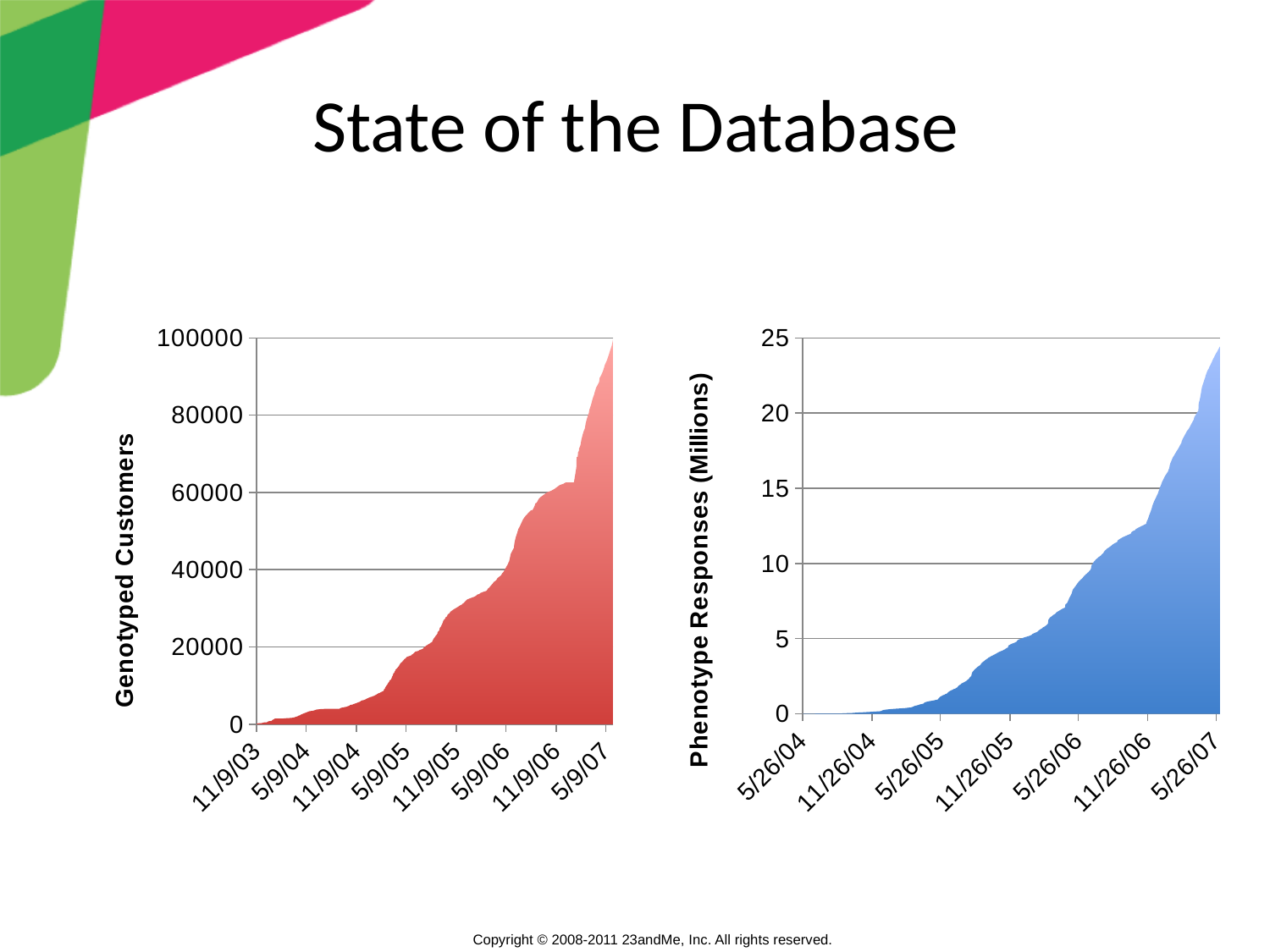
What kind of chart is the left chart, labelled Genotyped Customers? area chart What kind of chart is the right chart, labelled Phenotype Responses (Millions)? area chart In the left chart (Genotyped Customers), is the value at 11/9/05 greater or less than 20000? greater What is the y-axis title of the right chart? Phenotype Responses (Millions) How many date labels are shown on the x axis of the left chart (Genotyped Customers)? 8 In the left chart (Genotyped Customers), is the value at 5/9/07 greater or less than 80000? greater In the right chart (Phenotype Responses), is the value at 5/26/07 greater or less than 20? greater In the right chart (Phenotype Responses), do the values rise or fall over time along the x axis? rise In the left chart (Genotyped Customers), do the values rise or fall over time along the x axis? rise